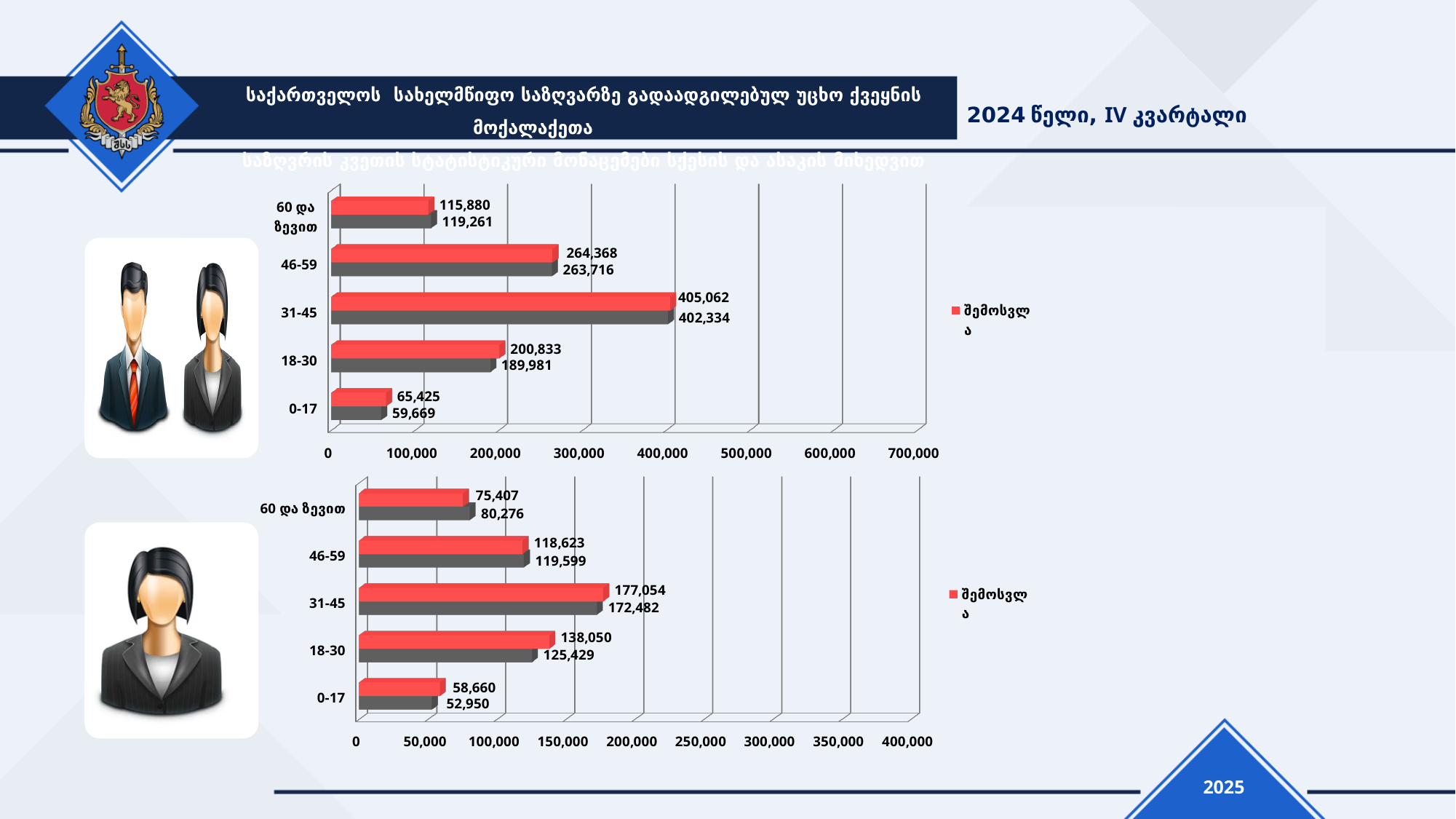
How many age group categories are shown in the bottom chart? 5 In the bottom chart, what is the value of the grey bar for the '60 და ზევით' age group? 80,276 In the top chart, which age group has the larger red bar value: 46-59 or 18-30? 46-59 What type of chart is the top chart? Bar chart In the bottom chart, which age group has the lowest grey bar value? 0-17 In the top chart, what is the value of the grey bar for the 0-17 age group? 59,669 In the top chart, which age group has the highest red bar value? 31-45 In the bottom chart, what is the value of the red bar for the 18-30 age group? 138,050 In the top chart, what is the value of the red bar for the 31-45 age group? 405,062 In the bottom chart, what is the difference between the red bar values for the 31-45 and 46-59 age groups? 58,431 What is the highest value shown on the x axis of the bottom chart? 400,000 In the top chart, what is the difference between the red bar and the grey bar for the 18-30 age group? 10,852